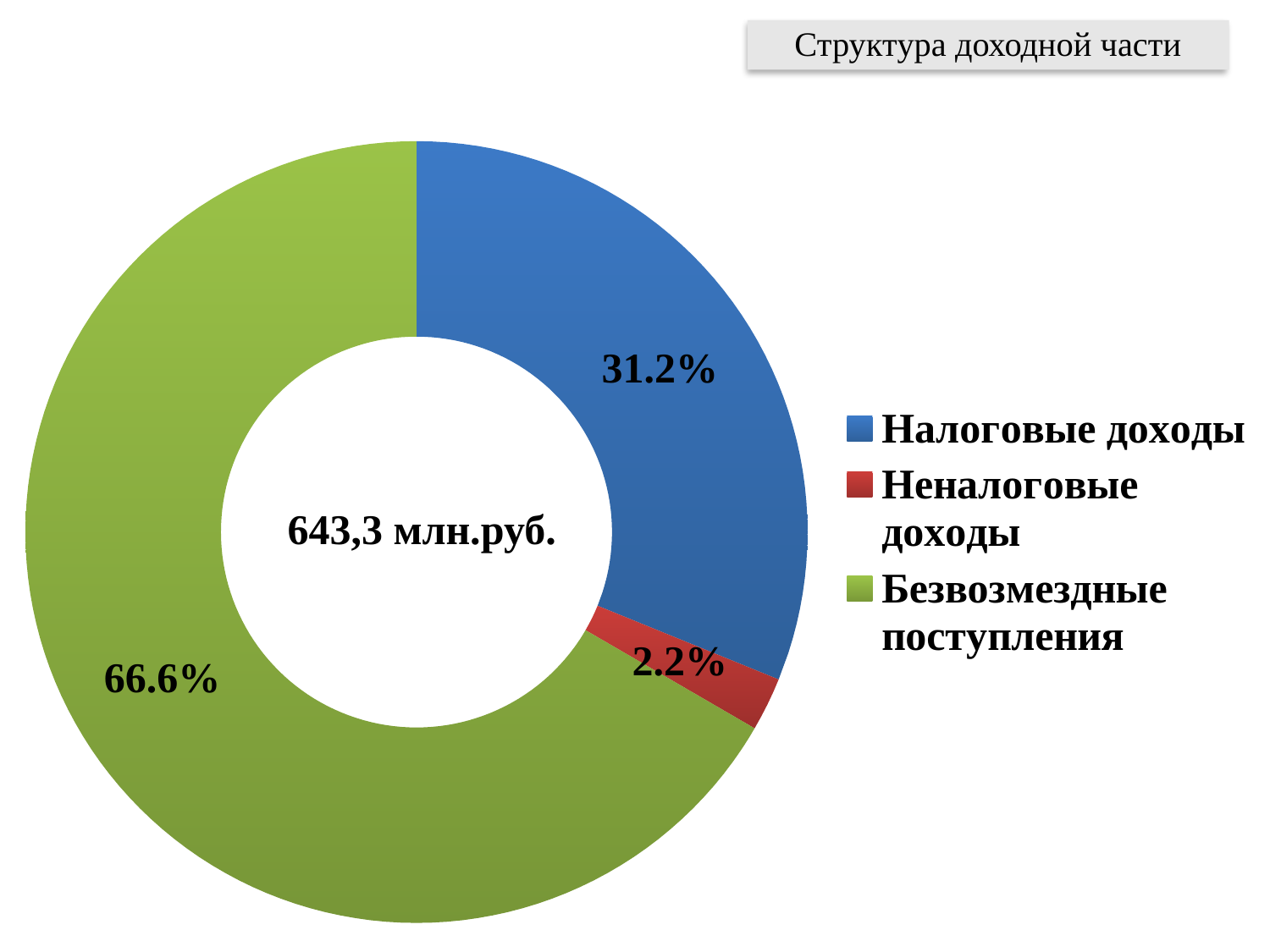
What share of the chart does Неналоговые доходы represent? 2.2% What total value is printed in the centre of the chart? 643,3 млн.руб. What share of the chart does Безвозмездные поступления represent? 66.6% Which category has the largest share of the chart? Безвозмездные поступления What is the difference in percentage points between Безвозмездные поступления and Налоговые доходы? 35.4 Which is larger, the share for Налоговые доходы or the share for Неналоговые доходы? Налоговые доходы How many categories does the chart show? 3 What kind of chart is shown on the slide? Pie chart (doughnut) Which category has the smallest share of the chart? Неналоговые доходы What share of the chart does Налоговые доходы represent? 31.2% What colour represents Безвозмездные поступления in the chart? Green What is the combined share of Налоговые доходы and Неналоговые доходы? 33.4%